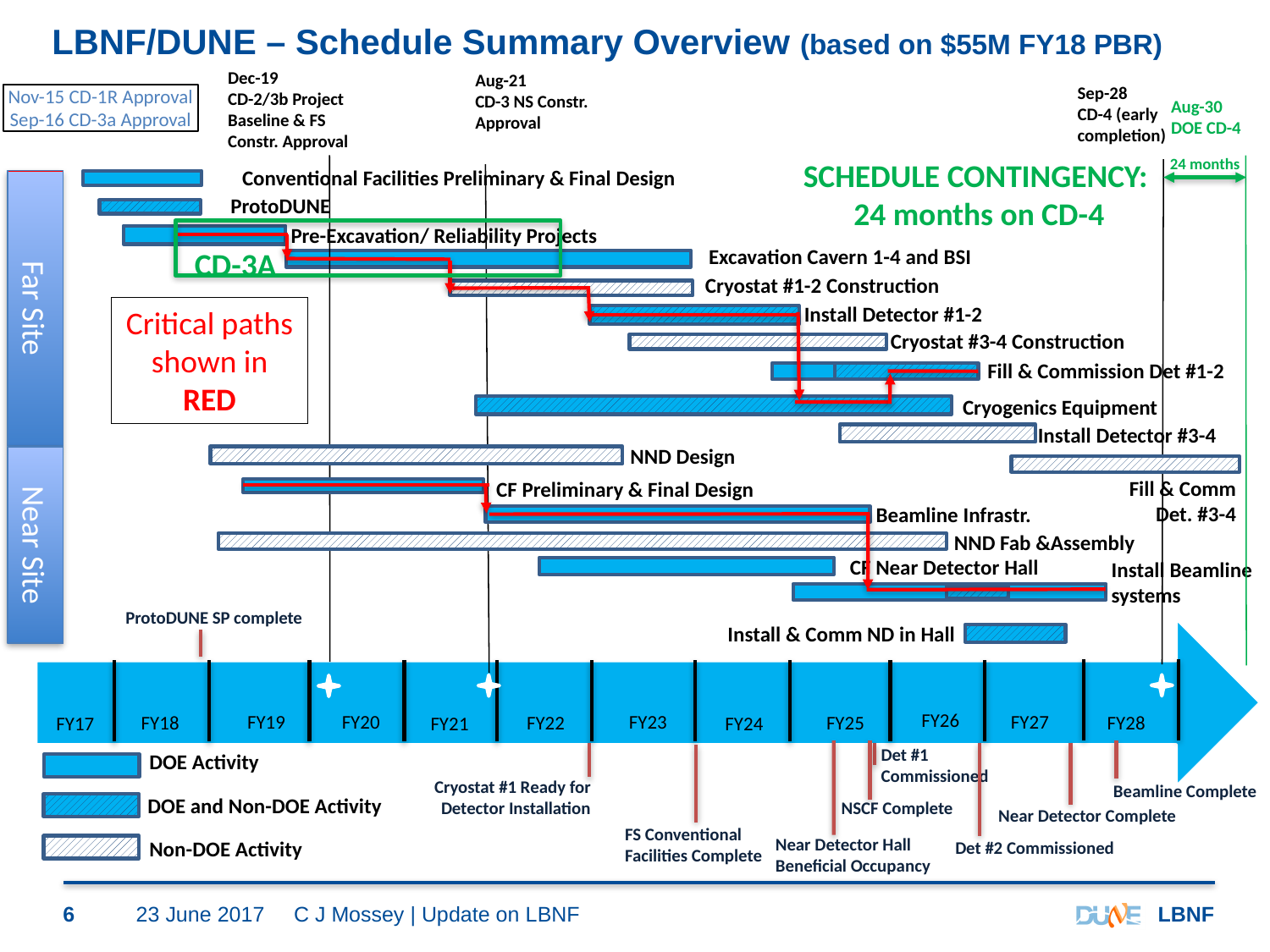
What is the CD-4 (early completion) date shown on the schedule? Sep-28 What is the date shown for CD-3a Approval? Sep-16 What is the date shown for CD-3 NS Constr. Approval? Aug-21 In what colour are the critical paths shown on the schedule? Red What is the DOE CD-4 date shown on the schedule? Aug-30 What is the date shown for CD-1R Approval? Nov-15 How many fiscal years are marked on the timeline axis, from FY17 to FY28? 12 How many activity types does the legend list? 3 How many months of schedule contingency are shown on CD-4? 24 months What is the date shown for the CD-2/3b Project Baseline & FS Constr. Approval? Dec-19 What are the two site groupings labelled on the left of the schedule? Far Site and Near Site Which milestone comes earlier on the schedule, CD-2/3b Project Baseline approval or CD-3 NS Constr. Approval? CD-2/3b Project Baseline approval (Dec-19)